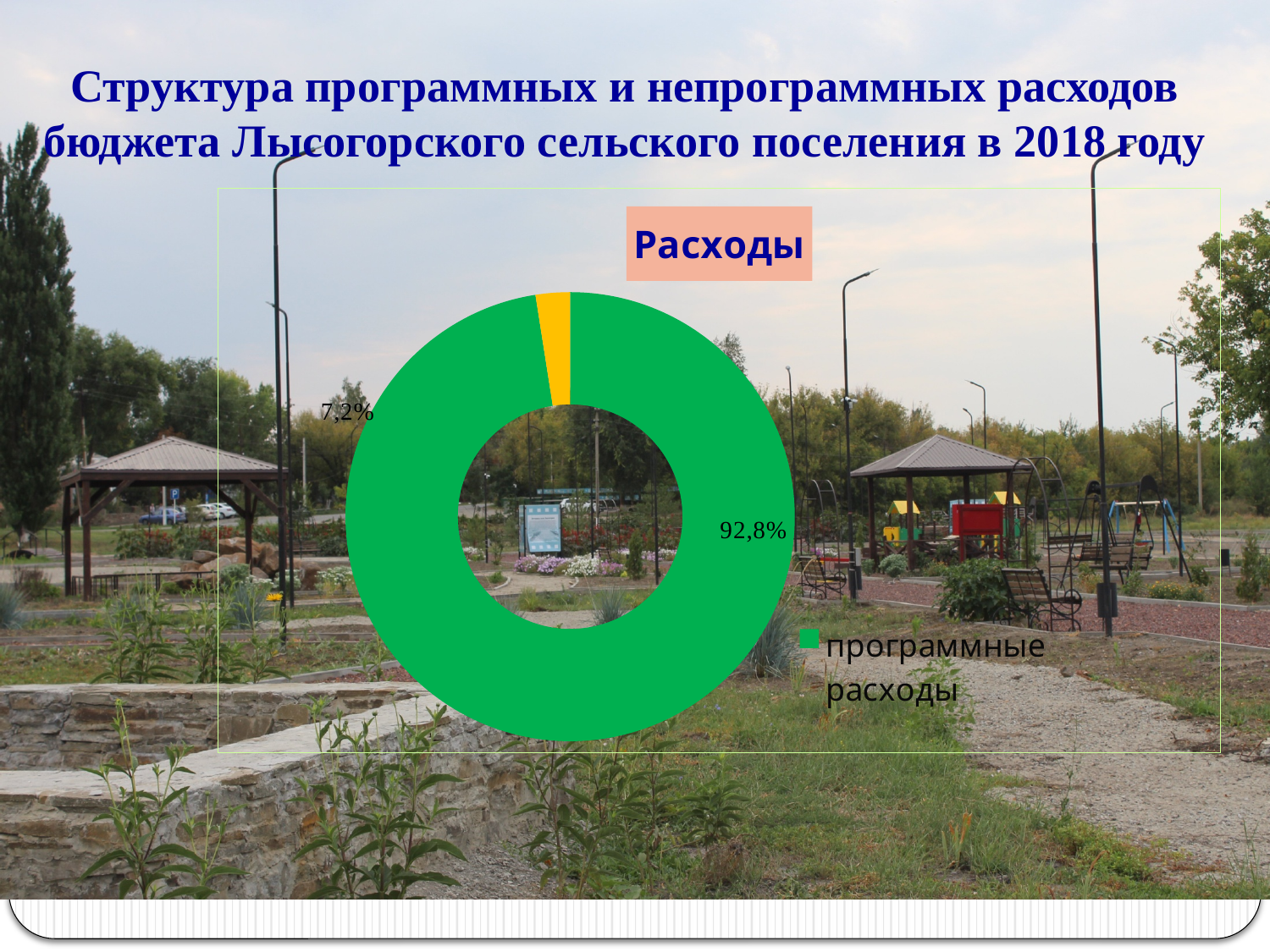
What colour is the slice for программные расходы? green Which is larger, the green slice or the yellow slice? the green slice What is the difference in percentage points between the green slice (92,8%) and the yellow slice (7,2%)? 85,6 percentage points What do the two slice percentages (92,8% and 7,2%) add up to? 100% What kind of chart is shown on the slide? doughnut chart How many entries does the chart legend list? 1 How many slices does the chart have? 2 Which slice of the chart is the largest? программные расходы (92,8%) What is the title of the chart? Расходы Which slice is smaller, the green one or the yellow one? the yellow one What percentage is shown for программные расходы? 92,8% What percentage is shown on the yellow slice of the chart? 7,2%